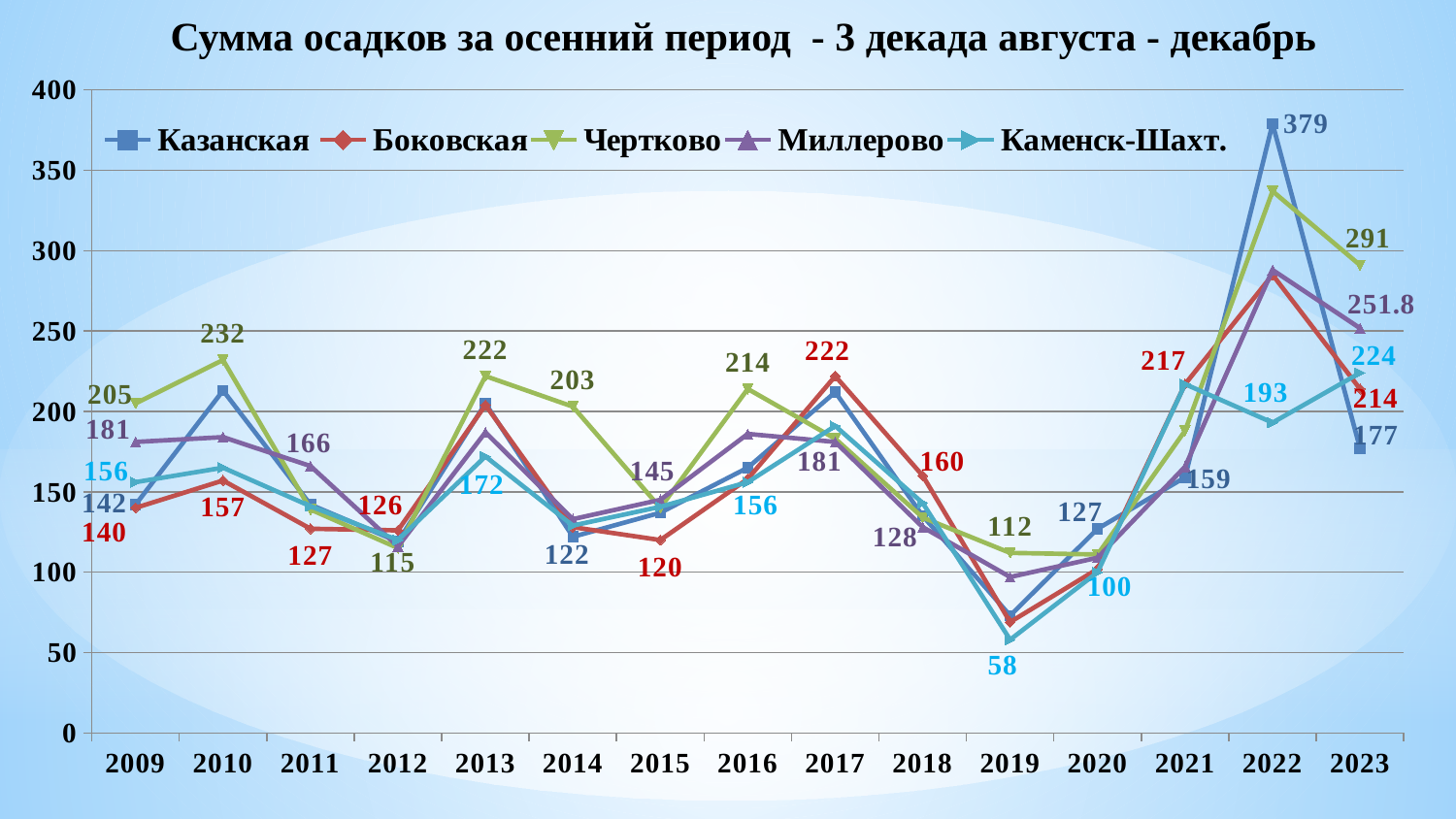
In which year does Казанская reach its highest value? 2022 What kind of chart is shown on the slide? line chart Which is larger in 2009: the value for Чертково or the value for Миллерово? Чертково How many years are shown along the x axis? 15 What is the title of the chart? Сумма осадков за осенний период - 3 декада августа - декабрь What is the value for Миллерово in 2023? 251.8 Is the value for Чертково in 2022 greater or less than 300? greater What is the value for Чертково in 2010? 232 What is the value for Каменск-Шахт. in 2019? 58 How many series does the legend list? 5 What is the value for Казанская in 2022? 379 What is the difference between the Чертково value and the Боковская value in 2023? 77